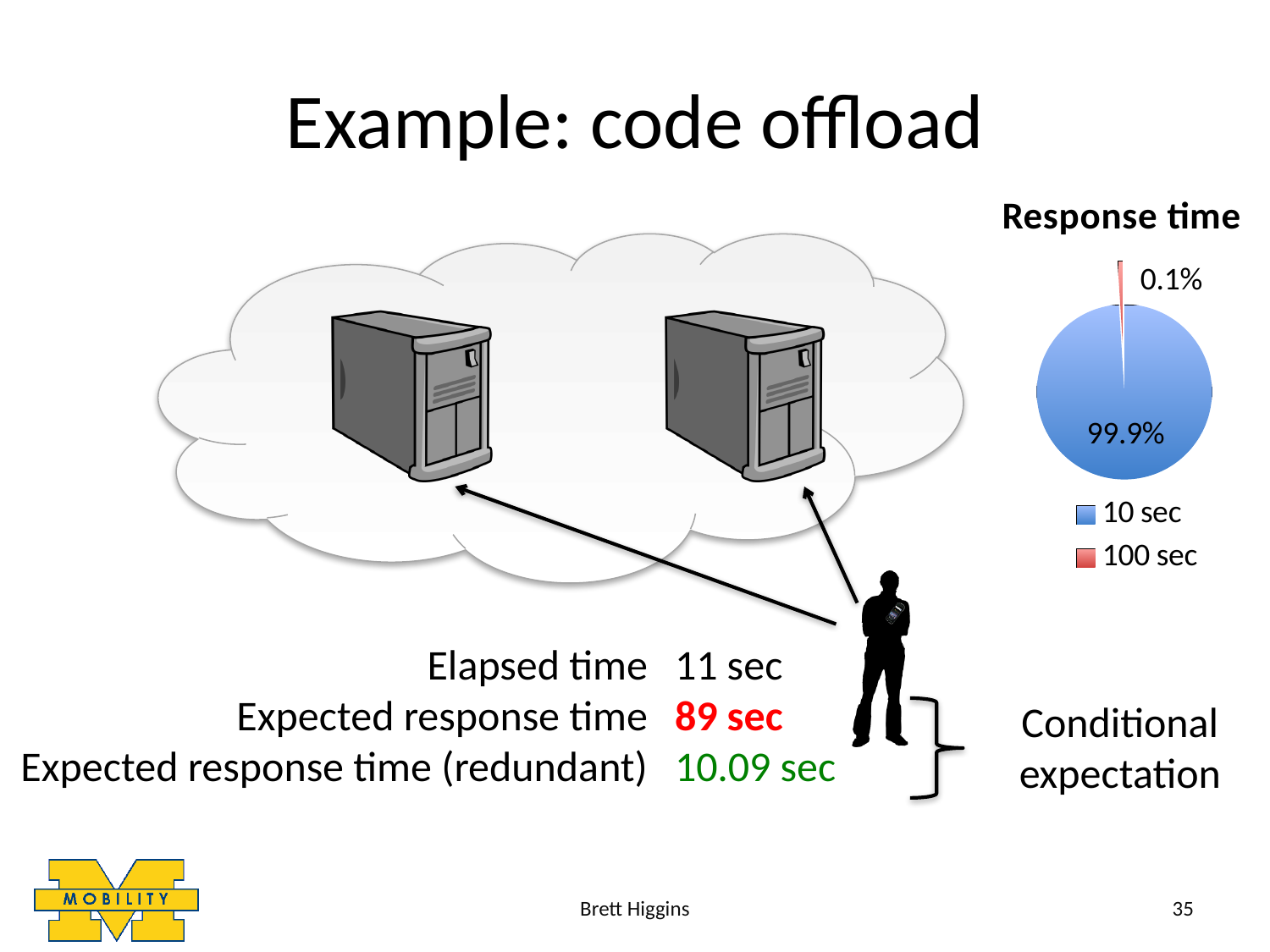
What share of the pie does the 10 sec slice represent? 99.9% What share of the pie does the 100 sec slice represent? 0.1% Which is larger, the 10 sec slice or the 100 sec slice? 10 sec What kind of chart is shown on the slide? pie chart How many slices does the pie chart have? 2 Which slice is the smallest in the pie chart? 100 sec How many entries does the legend list? 2 Which slice is the largest in the pie chart? 10 sec What is the difference in percentage points between the 10 sec slice and the 100 sec slice? 99.8% What is the title of the chart? Response time What colour is the 100 sec slice in the pie chart? red